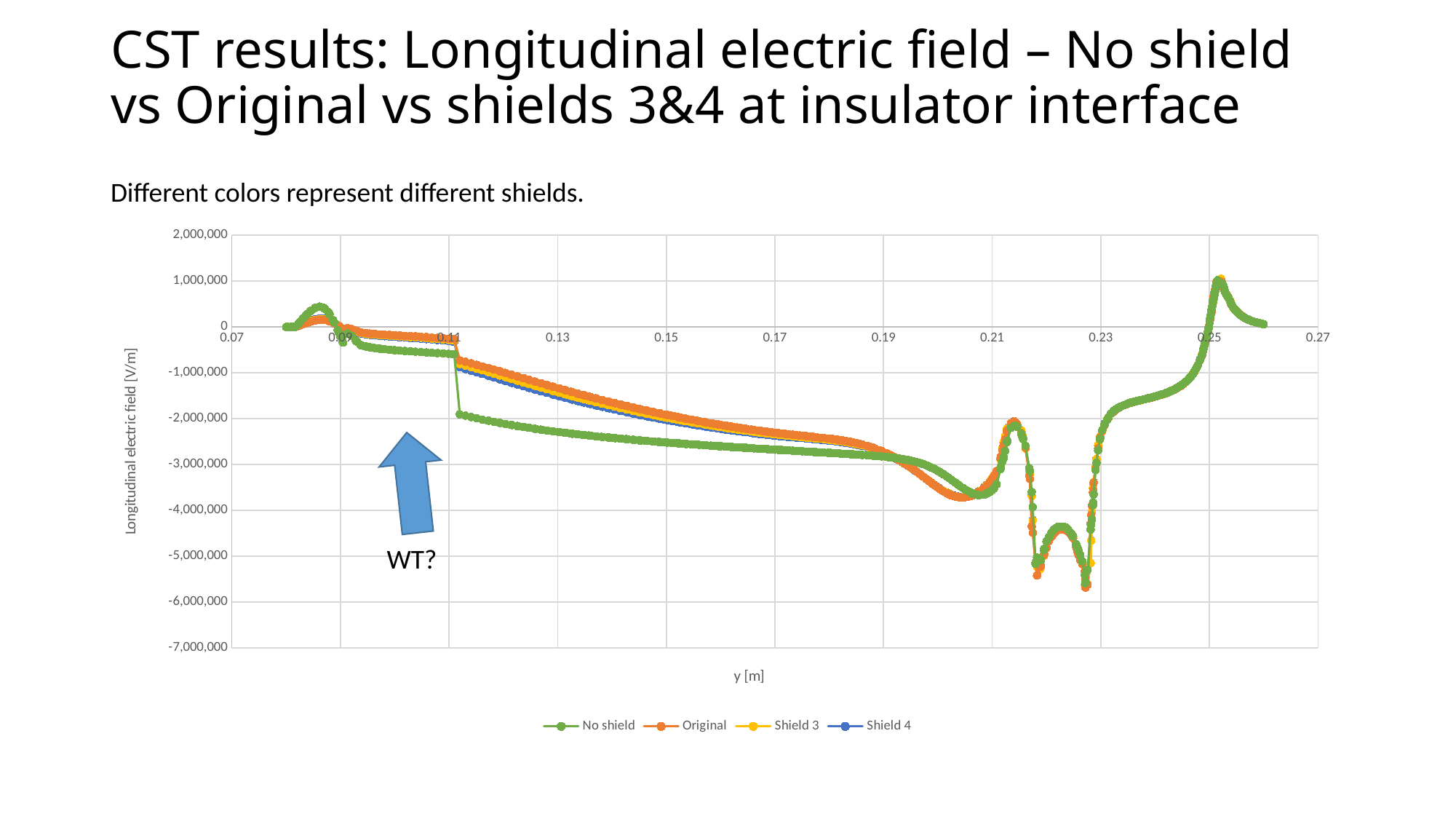
How many tick labels are shown on the x axis? 11 Is the value of the Original series at y = 0.13 m greater or less than -2,000,000? greater What kind of chart is shown on the slide? line chart What are the names of the series listed in the legend? No shield, Original, Shield 3, Shield 4 Is the value of the No shield series at y = 0.15 m greater or less than -2,000,000? less Is the lowest value reached by the Original series greater or less than -5,000,000? less How many series does the legend list? 4 Between y = 0.11 m and y = 0.19 m, do the values of the No shield series rise or fall? fall Between y = 0.23 m and y = 0.25 m, do the values of the series rise or fall? rise What is the label of the vertical axis? Longitudinal electric field [V/m] At y = 0.15 m, which series has the larger value, No shield or Original? Original At y = 0.15 m, which series has the lowest value? No shield